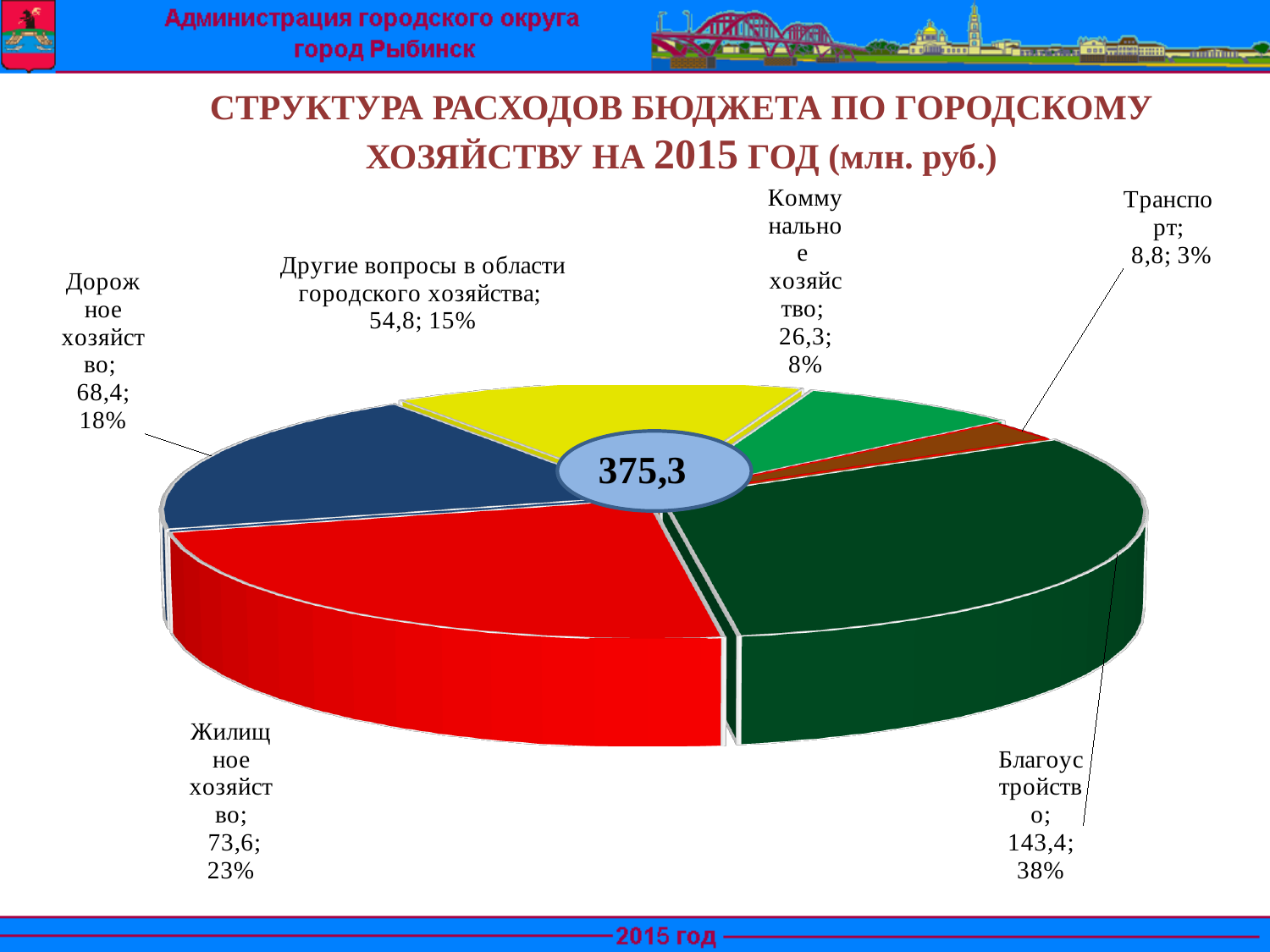
What is the difference between the values for Благоустройство and Жилищное хозяйство? 69,8 Which is larger: Дорожное хозяйство or Другие вопросы в области городского хозяйства? Дорожное хозяйство Which category has the largest value? Благоустройство What is the value for Благоустройство? 143,4 Which category has the smallest value? Транспорт What is the value for Транспорт? 8,8 What share of the pie does Дорожное хозяйство represent? 18% How many slices does the pie chart have? 6 What share of the pie does Коммунальное хозяйство represent? 8% What type of chart is shown on the slide? pie chart What total value is shown in the centre of the pie chart? 375,3 What is the value for Жилищное хозяйство? 73,6